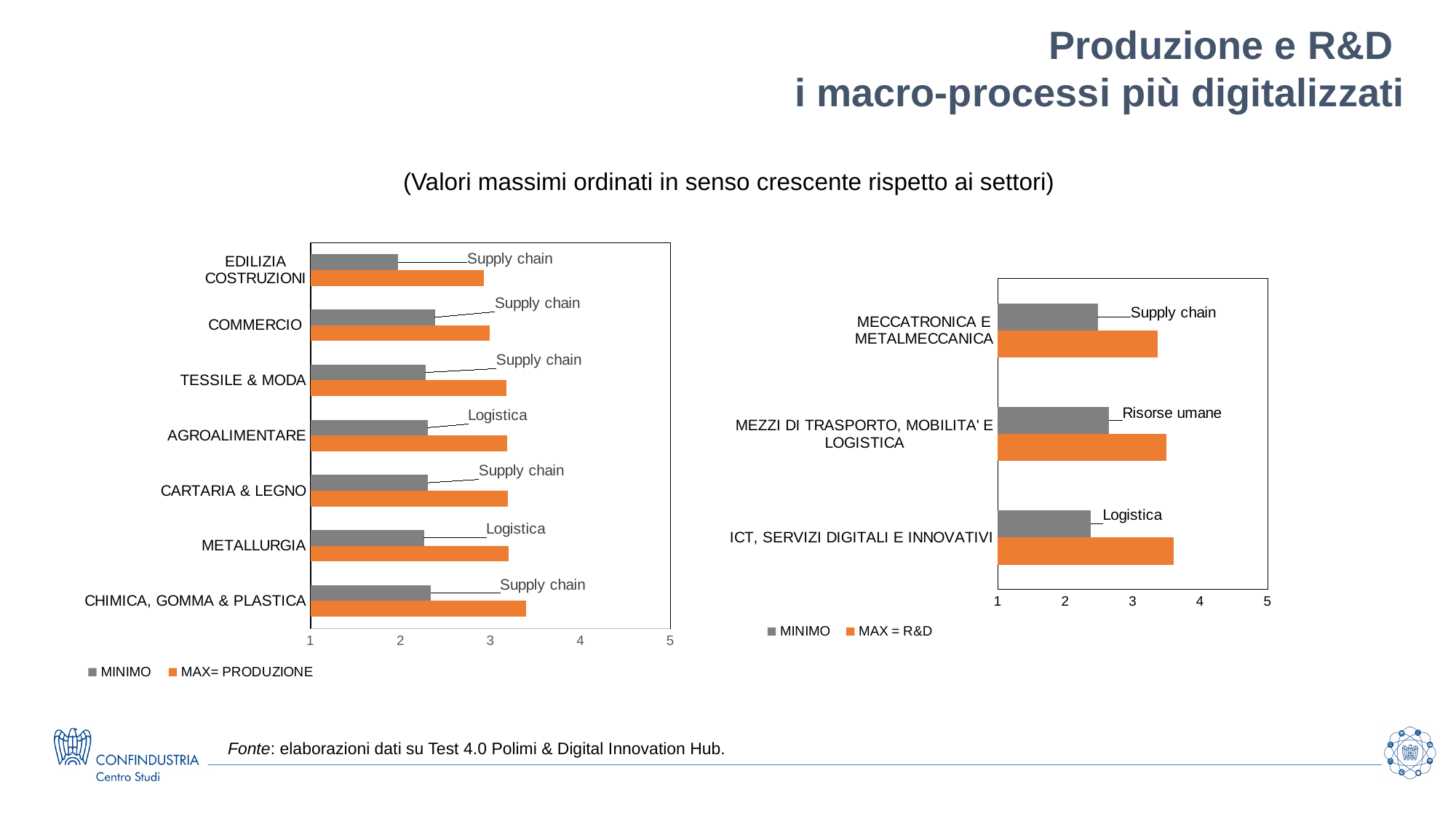
In the left chart (MAX= PRODUZIONE), how many sectors are shown? 7 In the left chart (MAX= PRODUZIONE), which sector has the highest MAX= PRODUZIONE value? CHIMICA, GOMMA & PLASTICA In the left chart (MAX= PRODUZIONE), which sector has the lowest MINIMO value? EDILIZIA COSTRUZIONI In the right chart, is the MINIMO value for ICT, SERVIZI DIGITALI E INNOVATIVI greater or less than 3? less In the left chart, which process is labelled as the minimum for AGROALIMENTARE? Logistica In the right chart (MAX = R&D), how many sectors are shown? 3 In the left chart, is the MAX= PRODUZIONE value for CHIMICA, GOMMA & PLASTICA greater or less than 3? greater How many series does the legend of the left chart list? 2 In the right chart, which process is labelled as the minimum for MEZZI DI TRASPORTO, MOBILITA' E LOGISTICA? Risorse umane In the right chart, is the MAX = R&D value for MECCATRONICA E METALMECCANICA greater or less than 3? greater What kind of chart is the right chart (MAX = R&D)? Bar chart